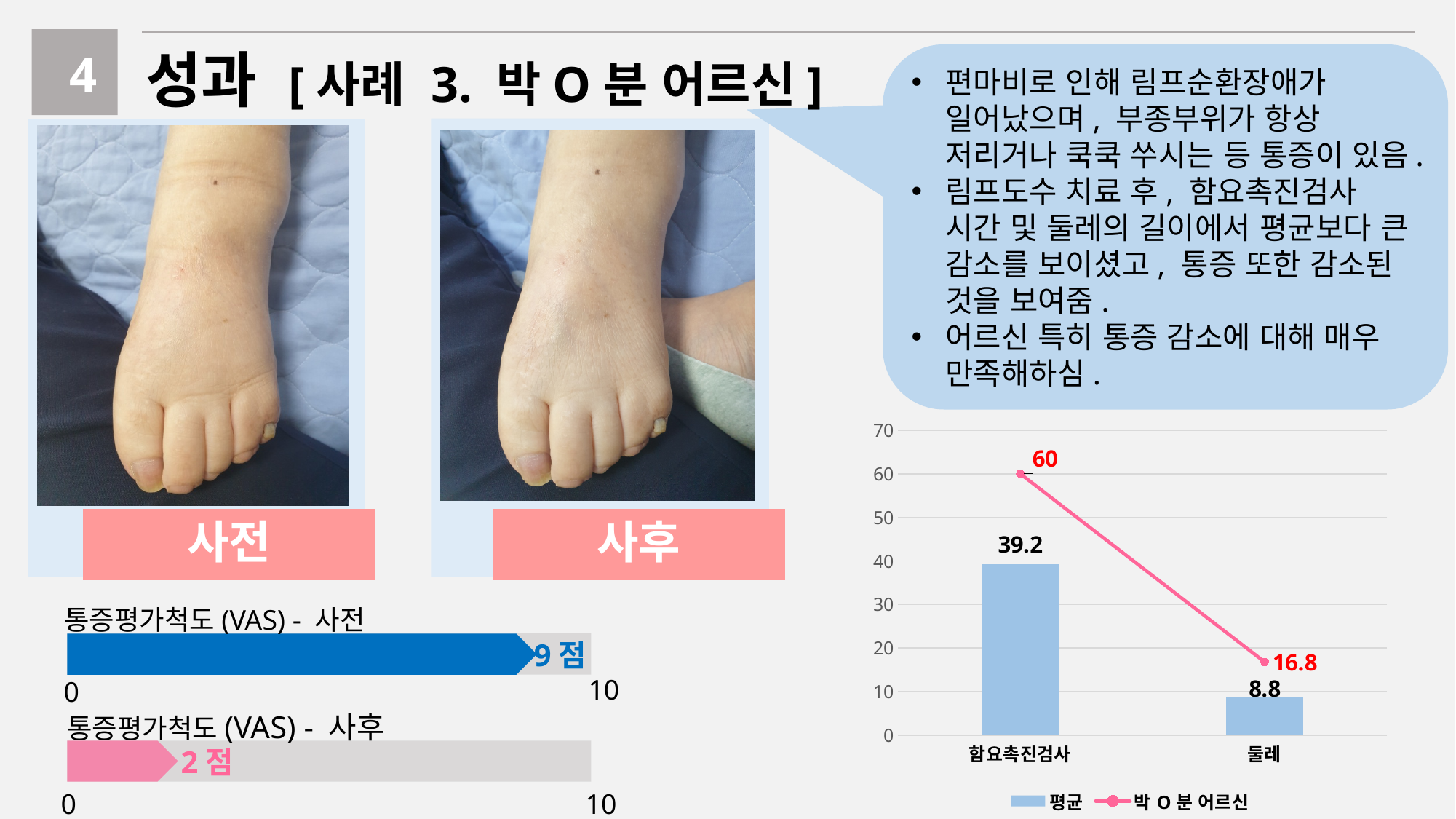
In the chart on the right, does the 박 O 분 어르신 line rise or fall from 함요촉진검사 to 둘레? fall In the chart on the right, what is the 평균 value for 둘레? 8.8 In the chart on the right, which category has the higher 평균 value? 함요촉진검사 How many categories are shown on the x axis of the chart on the right? 2 In the chart on the right, what is the difference between the 박 O 분 어르신 value and the 평균 value for 함요촉진검사? 20.8 In the chart on the right, what is the 박 O 분 어르신 value for 함요촉진검사? 60 In the chart on the right, what is the 박 O 분 어르신 value for 둘레? 16.8 In the 통증평가척도 (VAS) bars at the bottom left, what is the 사전 score and what is the 사후 score? 9 점 and 2 점 In the chart on the right, what is the 평균 value for 함요촉진검사? 39.2 How many series does the legend of the chart on the right list? 2 In the chart on the right, is the 박 O 분 어르신 value for 둘레 larger or smaller than the 평균 value for 둘레? larger In the chart on the right, what is the difference between the 박 O 분 어르신 value and the 평균 value for 둘레? 8